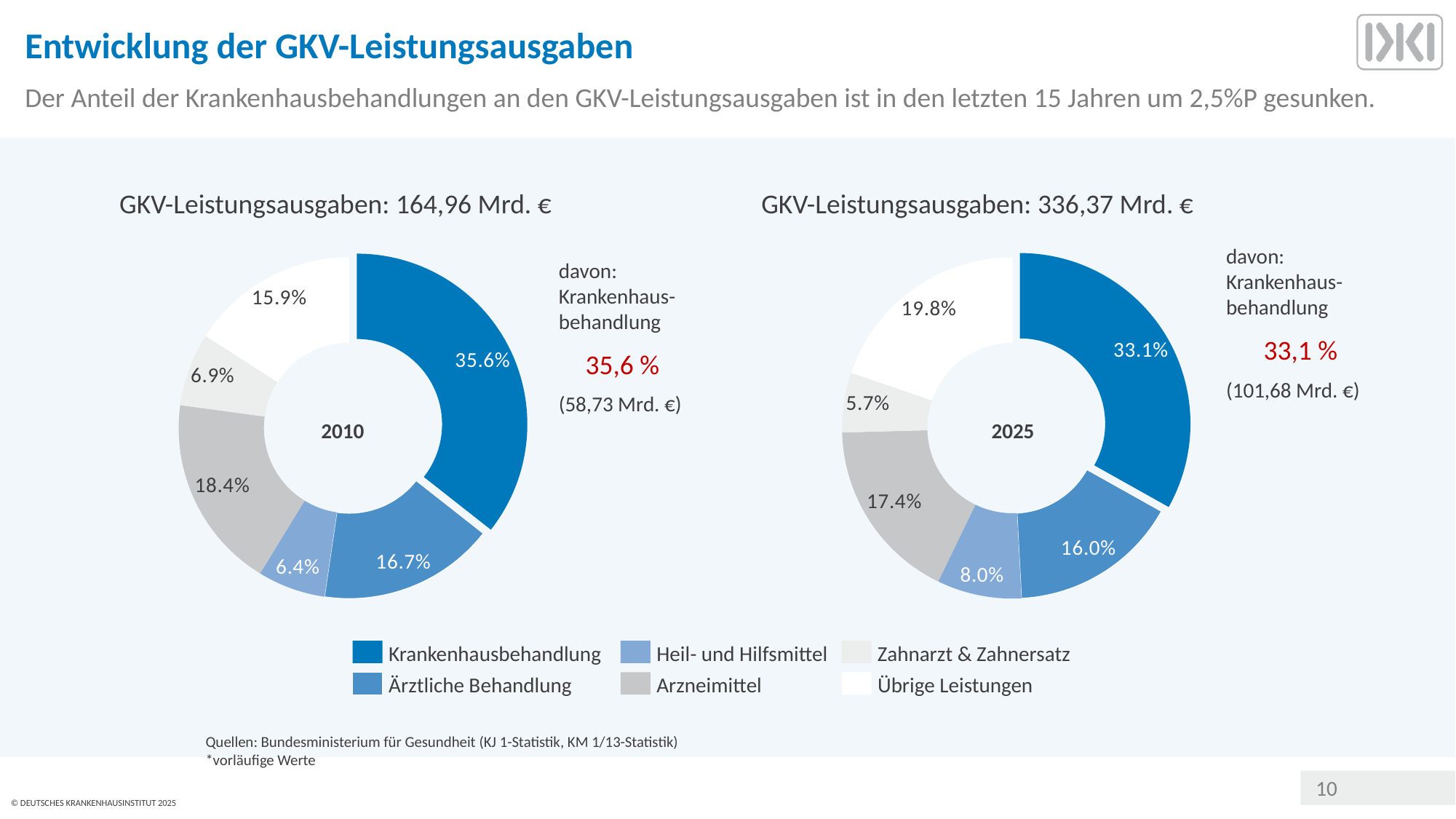
In the 2025 chart, which category has the smallest share? Zahnarzt & Zahnersatz How many categories does the legend list? 6 What is the difference between the Krankenhausbehandlung share in the 2010 chart and in the 2025 chart? 2.5 percentage points In the 2025 chart, what share is Arzneimittel? 17.4% In the 2010 chart, which category has the largest share? Krankenhausbehandlung What kind of chart is used on this slide? Donut (pie) chart In the 2010 chart, what share of GKV-Leistungsausgaben is Krankenhausbehandlung? 35.6% What total GKV-Leistungsausgaben is given in the title of the 2025 chart? 336,37 Mrd. € In the 2025 chart, which is larger: Ärztliche Behandlung or Heil- und Hilfsmittel? Ärztliche Behandlung In the 2010 chart, what share is Heil- und Hilfsmittel? 6.4% In the 2025 chart, what share is Übrige Leistungen? 19.8% How many slices does the 2010 chart have? 6